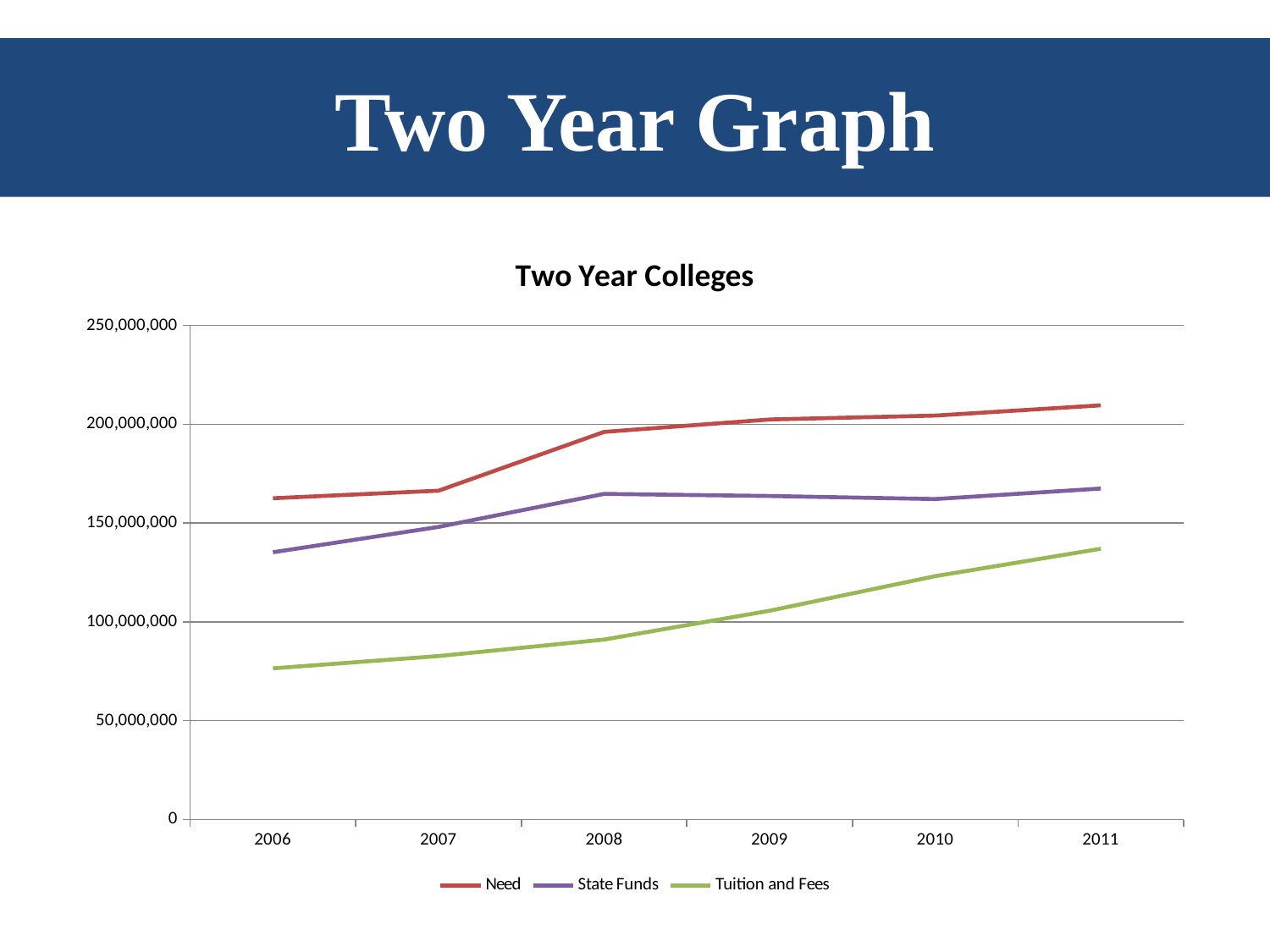
Is the value for State Funds in 2006 greater or less than 150,000,000? less Is the value for Tuition and Fees in 2010 greater or less than 100,000,000? greater What kind of chart is shown on the slide? line chart How many series does the legend list? 3 Which series has the lowest value in 2006? Tuition and Fees What is the title of the chart? Two Year Colleges Is the value for Tuition and Fees in 2006 greater or less than 100,000,000? less Which is larger in 2008, State Funds or Tuition and Fees? State Funds Does the Tuition and Fees line rise or fall from 2006 to 2011? rise How many years are plotted along the x axis? 6 Which series has the highest value in 2011? Need